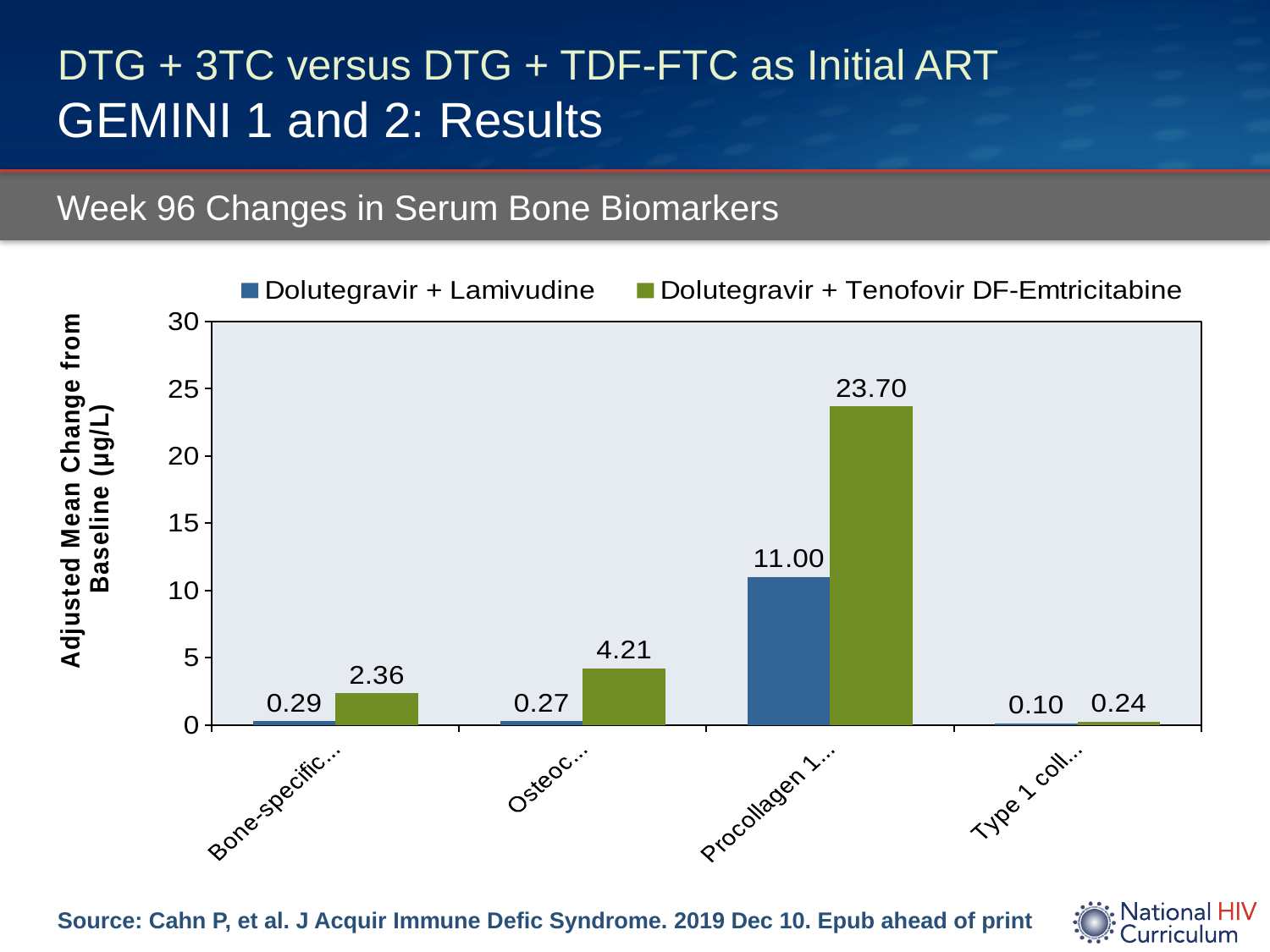
In the category labeled "Osteoc...", what is the difference between the Dolutegravir + Tenofovir DF-Emtricitabine value and the Dolutegravir + Lamivudine value? 3.94 What is the value for Dolutegravir + Lamivudine in the category labeled "Bone-specific..."? 0.29 In the category labeled "Procollagen 1...", what is the difference between the Dolutegravir + Tenofovir DF-Emtricitabine value and the Dolutegravir + Lamivudine value? 12.70 How many series does the chart legend list? 2 What is the value for Dolutegravir + Lamivudine in the category labeled "Procollagen 1..."? 11.00 Which category has the lowest value for Dolutegravir + Lamivudine? Type 1 coll... For Dolutegravir + Tenofovir DF-Emtricitabine, which is larger: the value in the "Bone-specific..." category or the value in the "Osteoc..." category? Osteoc... What is the value for Dolutegravir + Tenofovir DF-Emtricitabine in the category labeled "Procollagen 1..."? 23.70 Is the value for Dolutegravir + Tenofovir DF-Emtricitabine in the "Procollagen 1..." category greater or less than 20? greater How many categories are shown on the x axis of the chart? 4 Which category has the highest value for Dolutegravir + Tenofovir DF-Emtricitabine? Procollagen 1... What is the value for Dolutegravir + Tenofovir DF-Emtricitabine in the category labeled "Osteoc..."? 4.21